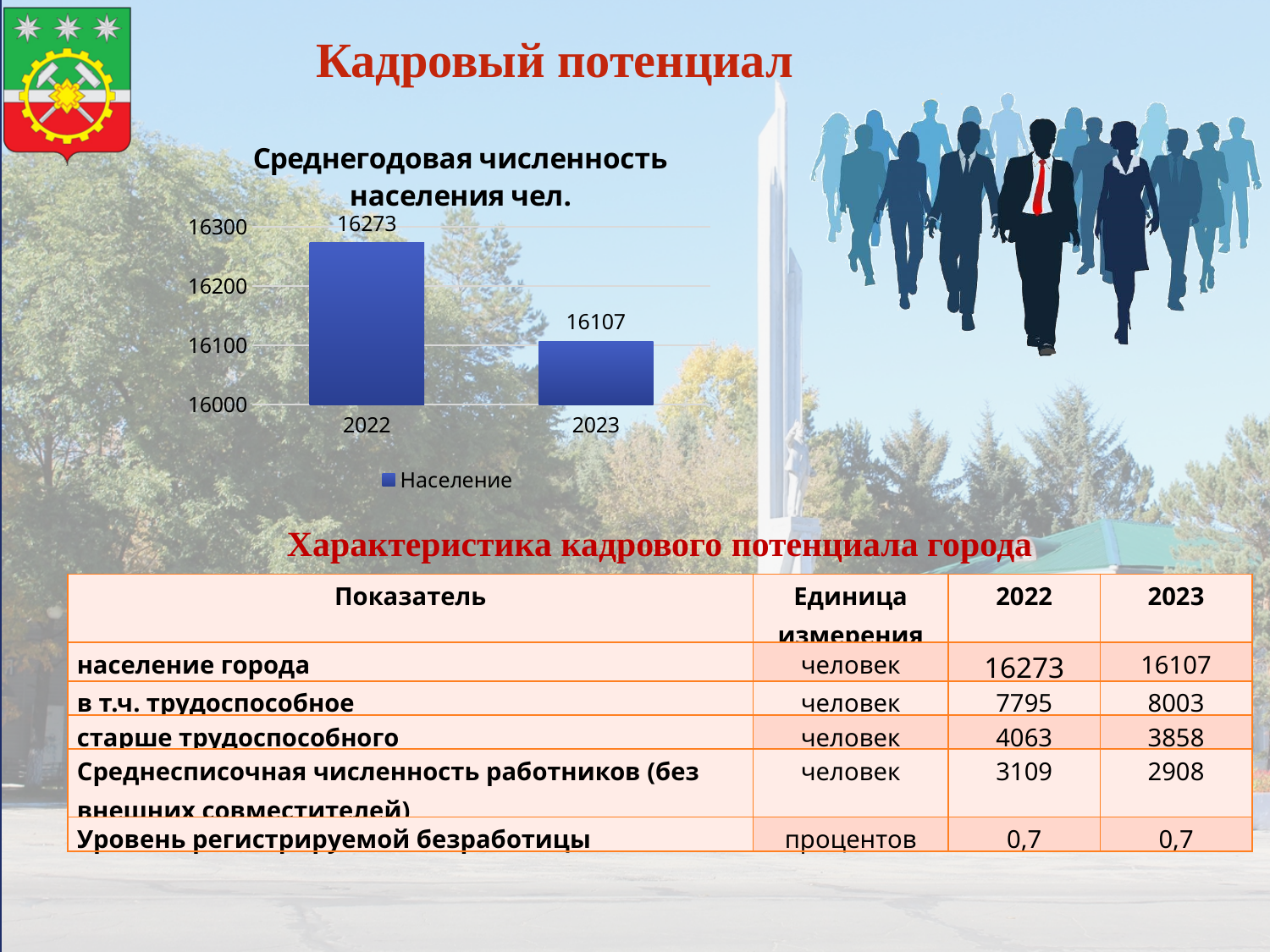
How many series does the chart legend list? 1 What kind of chart is shown on the slide? bar chart Which year has the highest value in the chart? 2022 Do the values in the chart rise or fall from 2022 to 2023? fall What is the title of the chart? Среднегодовая численность населения чел. What is the value for 2023 in the chart? 16107 What is the difference between the 2022 and 2023 values in the chart? 166 What is the value for 2022 in the chart? 16273 How many categories are shown on the x axis of the chart? 2 Which is larger in the chart, the value for 2022 or for 2023? 2022 Which year has the lowest value in the chart? 2023 Is the value for 2023 in the chart greater or less than 16200? less